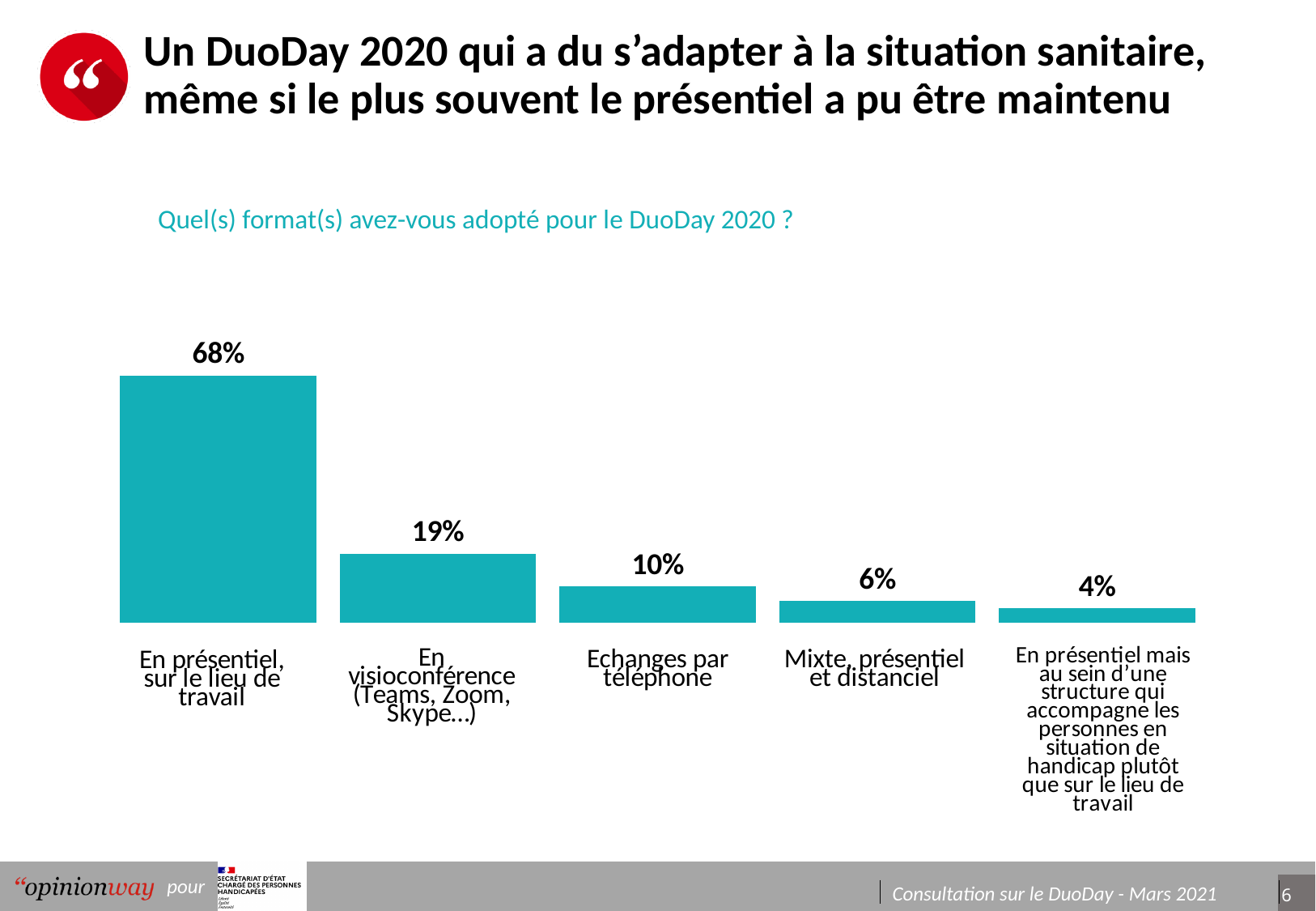
Which format has the lowest percentage? En présentiel mais au sein d'une structure qui accompagne les personnes en situation de handicap plutôt que sur le lieu de travail What is the difference in percentage points between 'En présentiel, sur le lieu de travail' and 'En visioconférence (Teams, Zoom, Skype…)'? 49 percentage points What type of chart is used on this slide? Bar chart Which format has the highest percentage? En présentiel, sur le lieu de travail What question does the chart answer, as written above it? Quel(s) format(s) avez-vous adopté pour le DuoDay 2020 ? What percentage of respondents adopted the 'En présentiel, sur le lieu de travail' format for DuoDay 2020? 68% What percentage is shown for 'Echanges par téléphone'? 10% What is the value shown for 'En visioconférence (Teams, Zoom, Skype…)'? 19% Do the values rise or fall from left to right across the categories? Fall How many format categories are shown in the chart? 5 Which is larger: the value for 'Echanges par téléphone' or for 'Mixte, présentiel et distanciel'? Echanges par téléphone What is the value for 'Mixte, présentiel et distanciel'? 6%